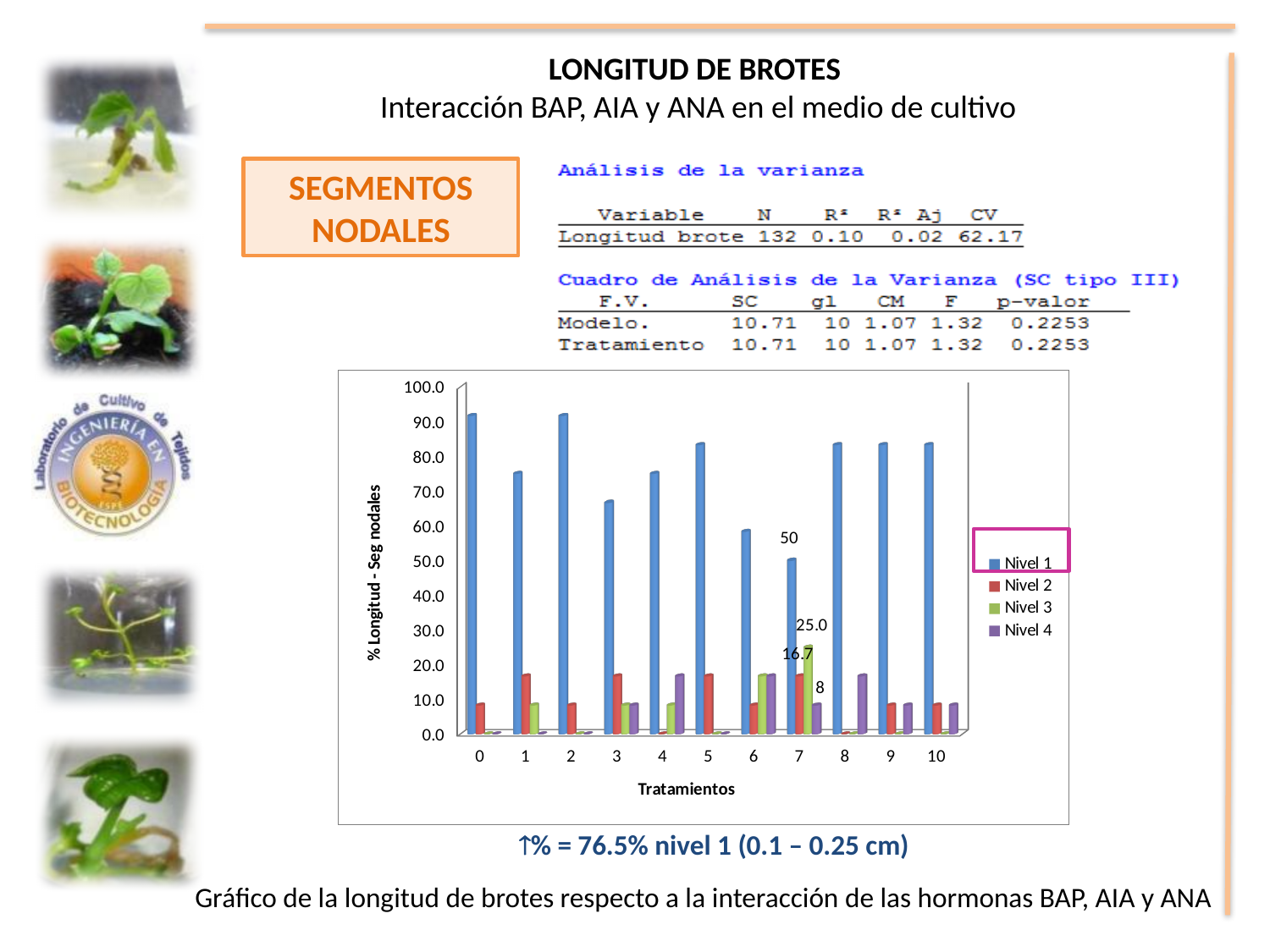
For which treatment is the Nivel 1 value lowest? 7 Is the Nivel 1 value for treatment 3 greater or less than 70? less What is the value of Nivel 2 for treatment 7? 16.7 What is the value of Nivel 4 for treatment 7? 8 What is the value of Nivel 3 for treatment 7? 25.0 What kind of chart is shown on the slide? bar chart How many series does the chart legend list? 4 For treatment 7, what is the difference between the Nivel 3 value and the Nivel 2 value? 8.3 For treatment 7, which is larger: Nivel 2 or Nivel 3? Nivel 3 How many treatment categories are shown on the x axis of the chart? 11 What is the value of Nivel 1 for treatment 7? 50 What is the title of the x axis of the chart? Tratamientos